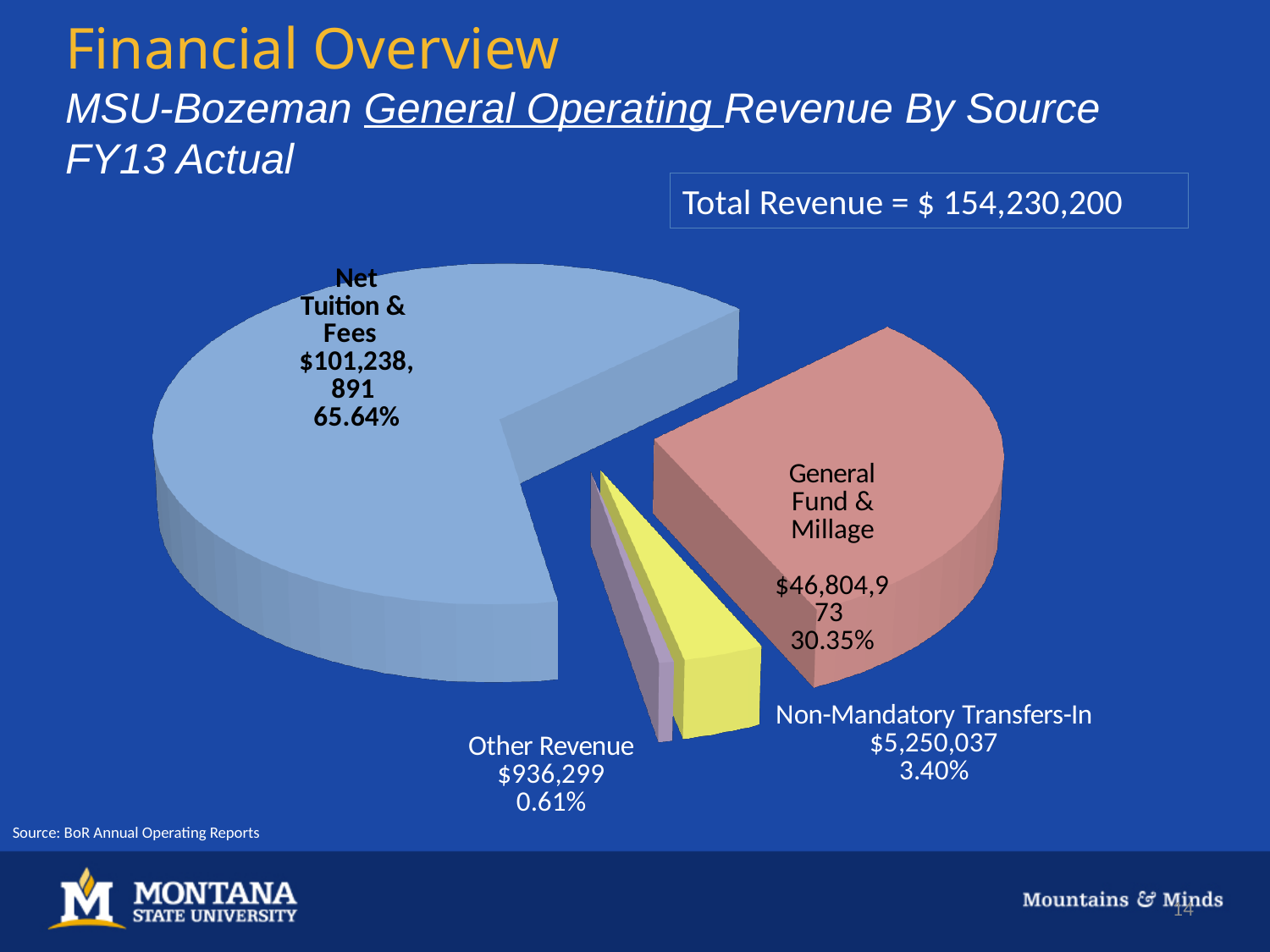
What is the value for Net Tuition & Fees? $101,238,891 What kind of chart is shown on the slide? Pie chart Which revenue source is the largest? Net Tuition & Fees What share of the pie does General Fund & Millage represent? 30.35% What is the difference in value between Net Tuition & Fees and General Fund & Millage? $54,433,918 How many revenue sources are shown in the pie chart? 4 What total revenue is stated on the slide? $ 154,230,200 What is the value for Non-Mandatory Transfers-In? $5,250,037 What share of the pie does Other Revenue represent? 0.61% Which revenue source is the smallest? Other Revenue What is the difference in percentage share between Net Tuition & Fees and General Fund & Millage? 35.29% Which is larger, Non-Mandatory Transfers-In or Other Revenue? Non-Mandatory Transfers-In